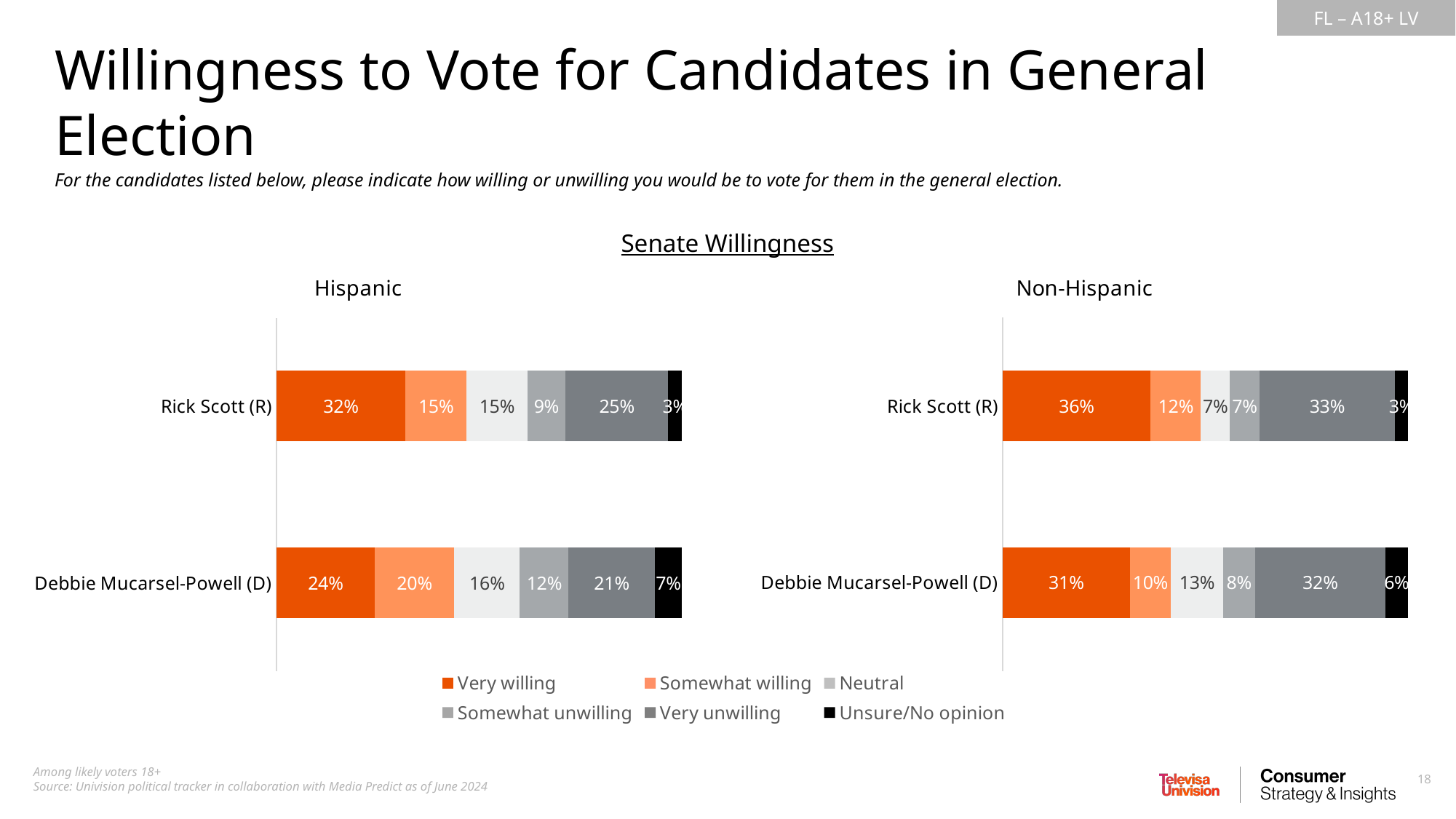
In the Hispanic chart, what is the difference between the somewhat willing percentages for Debbie Mucarsel-Powell (D) and Rick Scott (R)? 5% Which legend entry is shown in black? Unsure/No opinion In the Hispanic chart, what percentage of respondents are very willing to vote for Rick Scott (R)? 32% In the Non-Hispanic chart, what is the difference between the very willing percentages for Rick Scott (R) and Debbie Mucarsel-Powell (D)? 5% In the Hispanic chart, what is the combined very willing and somewhat willing percentage for Debbie Mucarsel-Powell (D)? 44% In the Hispanic chart, which candidate has the higher very willing percentage? Rick Scott (R) How many candidates are shown in the Non-Hispanic chart? 2 What kind of chart is used to show Senate Willingness? Stacked bar chart In the Non-Hispanic chart, what percentage of respondents are neutral on Rick Scott (R)? 7% How many series does the legend list? 6 In the Non-Hispanic chart, what percentage of respondents are very unwilling to vote for Debbie Mucarsel-Powell (D)? 32% In the Hispanic chart, what percentage of respondents are unsure/no opinion about Debbie Mucarsel-Powell (D)? 7%